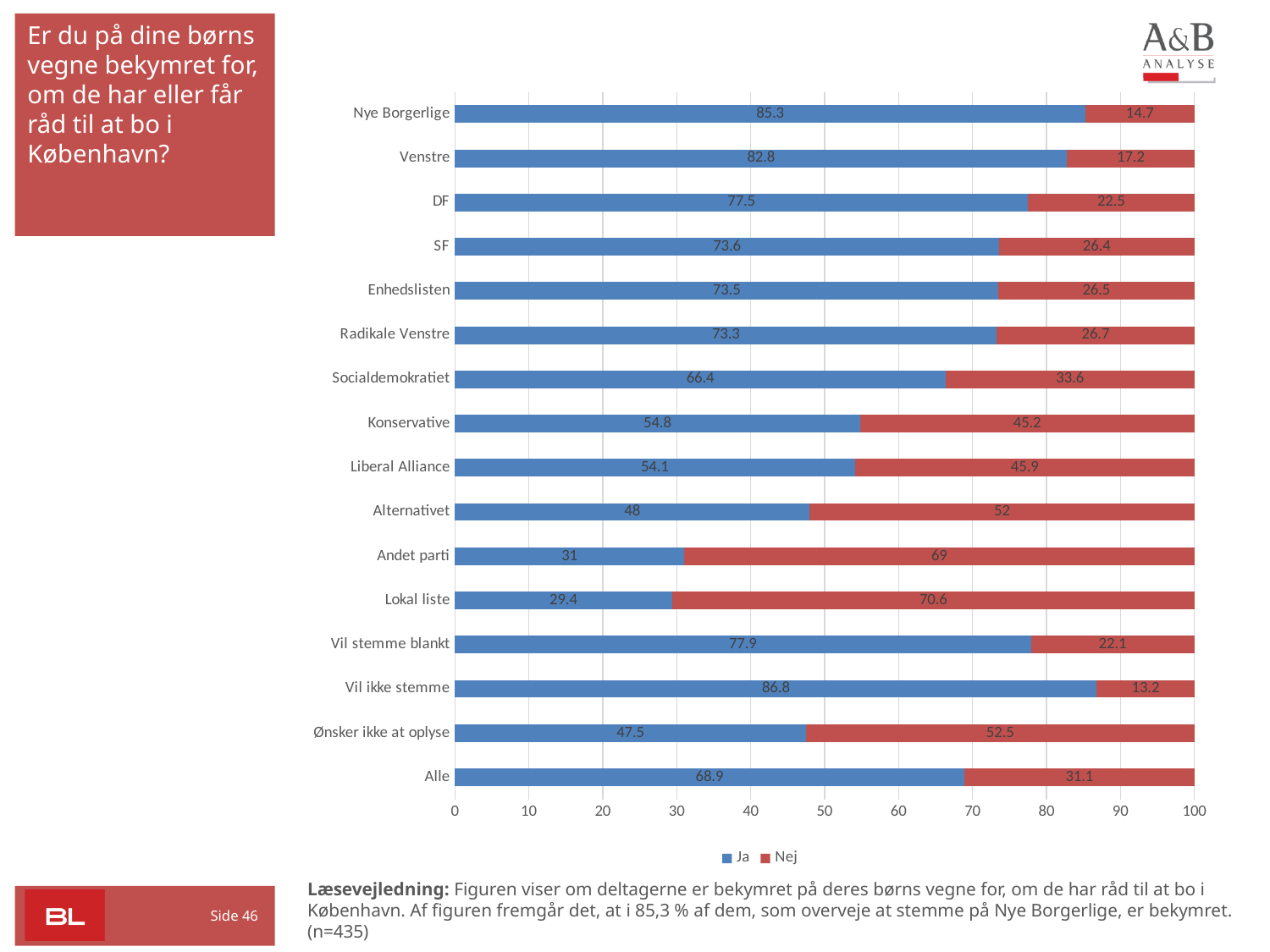
How many categories are shown on the chart? 16 What kind of chart is shown on the slide? Stacked bar chart How many series does the legend list? 2 Is the "Ja" value for Andet parti greater or less than 40? less What is the "Ja" value for Alle? 68.9 What is the "Ja" value for Nye Borgerlige? 85.3 What is the "Nej" value for Socialdemokratiet? 33.6 Which category has the highest "Ja" value? Vil ikke stemme What is the total of the stacked bar for Liberal Alliance? 100 Which has a larger "Nej" value, Konservative or Alternativet? Alternativet Which category has the lowest "Ja" value? Lokal liste What is the difference between the "Ja" values for Venstre and DF? 5.3